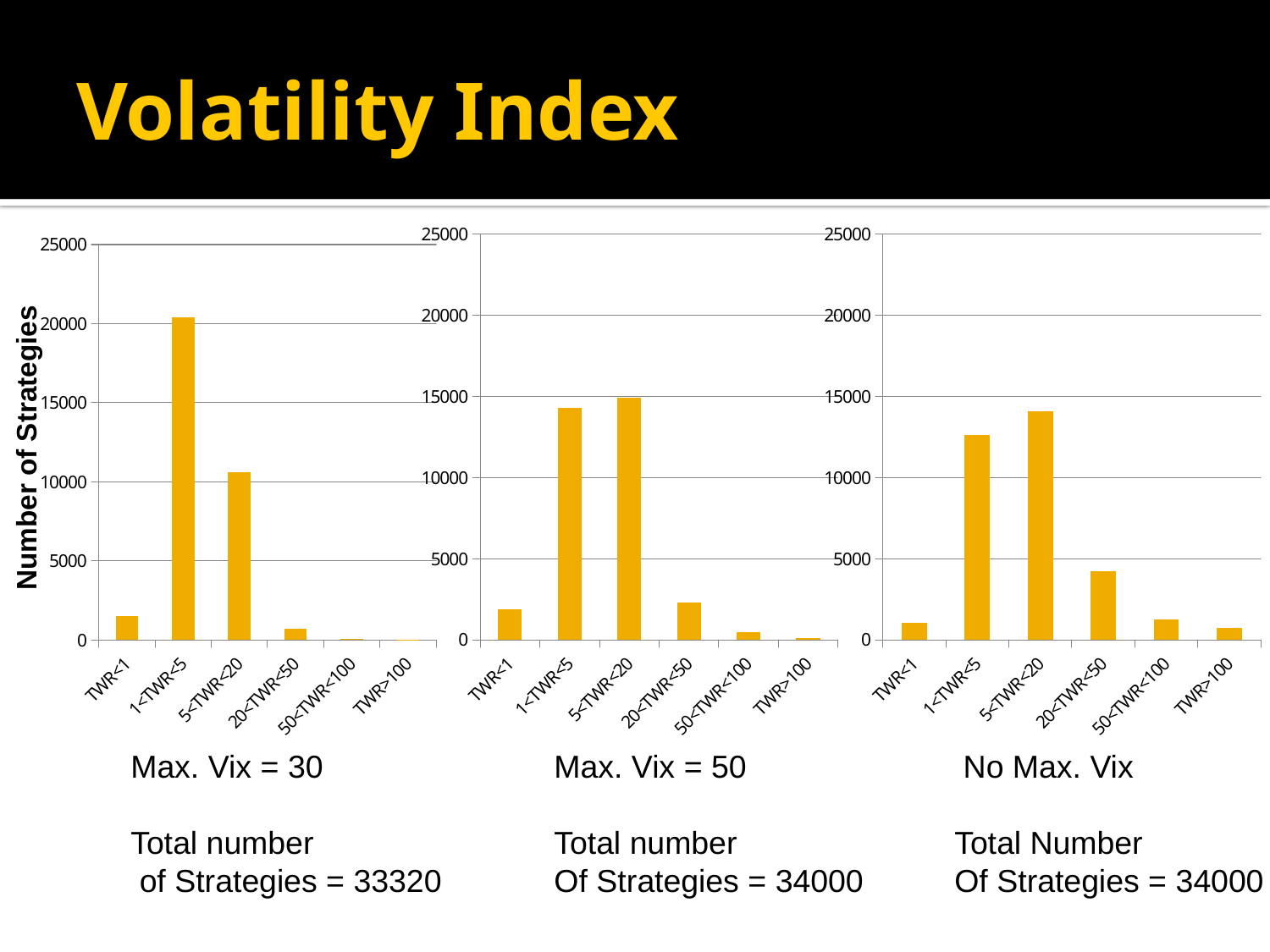
What kind of chart is the 'Max. Vix = 30' chart? bar chart In the 'No Max. Vix' chart, which category has the highest number of strategies? 5<TWR<20 In the 'Max. Vix = 30' chart, is the value for 1<TWR<5 greater or less than 20000? greater According to the text under the 'Max. Vix = 30' chart, what is the total number of strategies? 33320 In the 'Max. Vix = 50' chart, is the value for 1<TWR<5 greater or less than 15000? less In the 'Max. Vix = 30' chart, which category has the highest number of strategies? 1<TWR<5 In the 'Max. Vix = 30' chart, which is larger: the value for 5<TWR<20 or the value for 20<TWR<50? 5<TWR<20 What is the label on the y axis of the 'Max. Vix = 30' chart? Number of Strategies In the 'Max. Vix = 50' chart, which category has the highest number of strategies? 5<TWR<20 How many categories are shown on the x axis of the 'Max. Vix = 50' chart? 6 In the 'Max. Vix = 50' chart, which category has the lowest number of strategies? TWR>100 In the 'No Max. Vix' chart, is the value for 20<TWR<50 greater or less than 5000? less